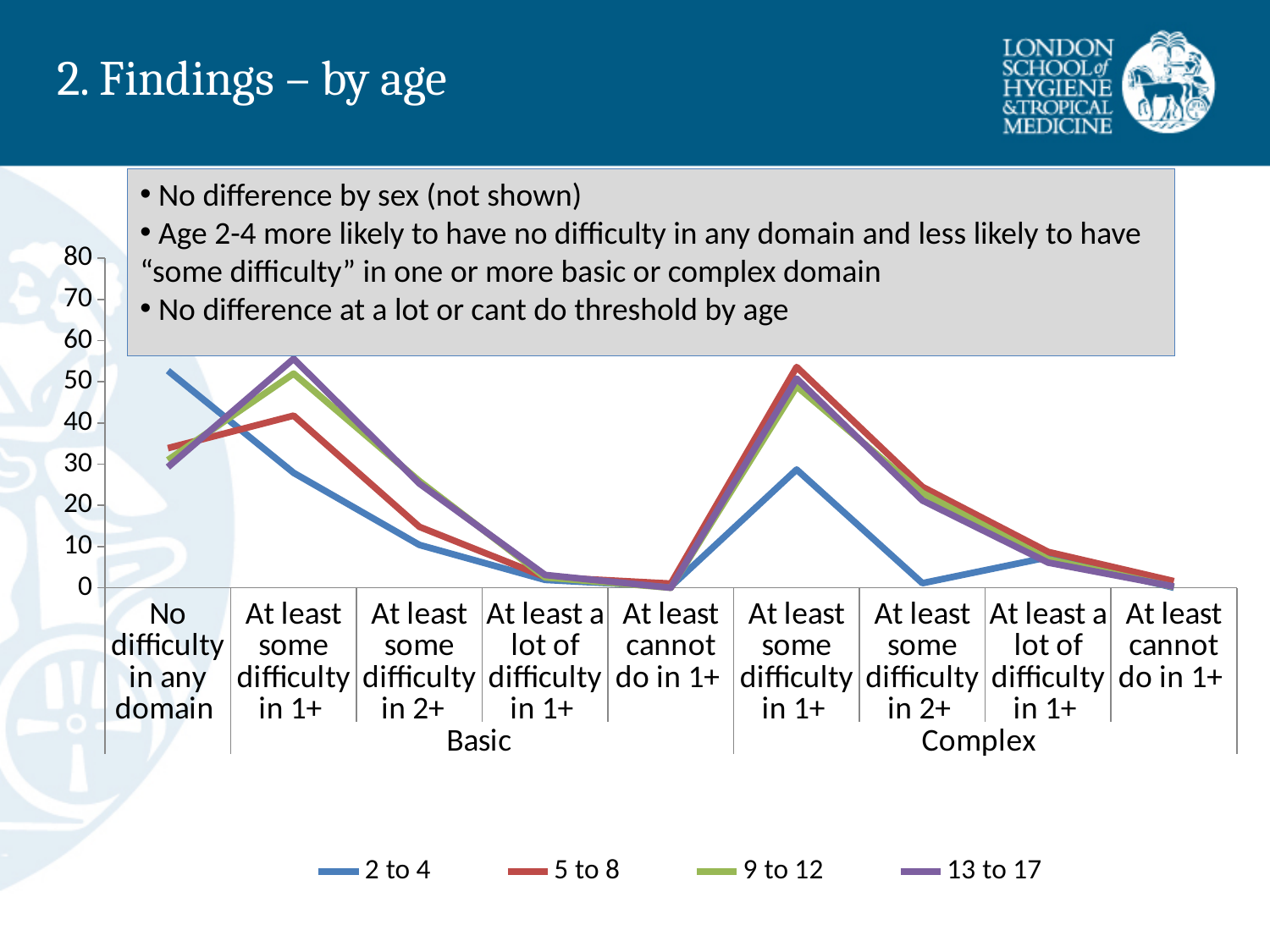
Is the value for the 2 to 4 age group at "At least some difficulty in 1+" in the Basic group greater or less than 40? less How many series does the legend list? 4 What kind of chart is shown on the slide? Line chart How many categories are shown along the x axis? 9 For the 2 to 4 age group, do the values rise or fall from "No difficulty in any domain" to "At least cannot do in 1+" in the Basic group? fall Is the value for the 5 to 8 age group at "At least some difficulty in 1+" in the Complex group greater or less than 40? greater Which is larger at "No difficulty in any domain": the value for 2 to 4 or the value for 5 to 8? 2 to 4 Which age group has the lowest value for "At least some difficulty in 1+" in the Basic group? 2 to 4 Is the value for the 2 to 4 age group at "At least some difficulty in 2+" in the Complex group greater or less than 10? less Which age group has the highest value for "No difficulty in any domain"? 2 to 4 What are the two domain groups labelled beneath the x axis? Basic and Complex